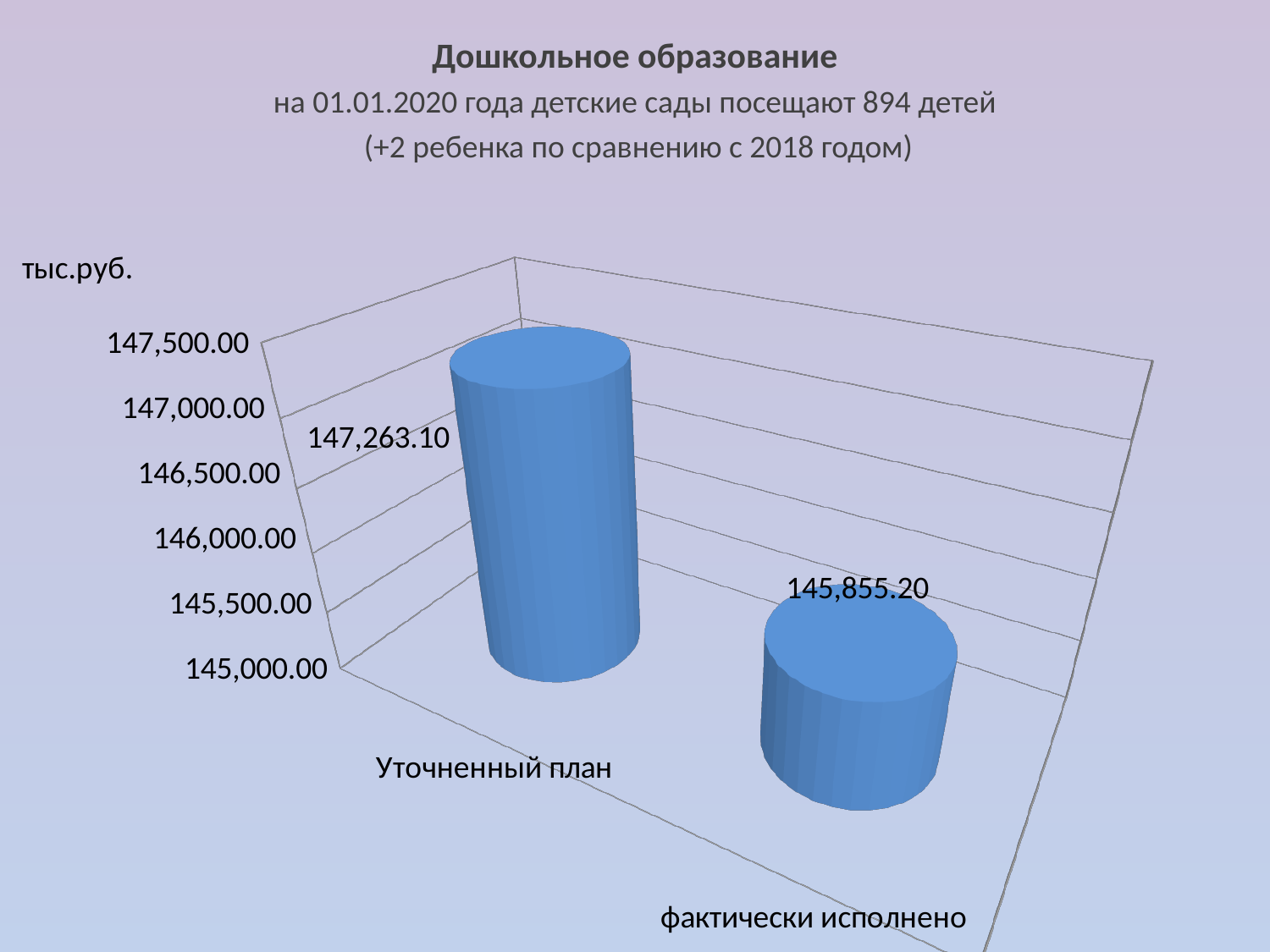
Is the value for Уточненный план greater or less than 147,000.00? greater What unit is shown for the values on the chart? тыс.руб. How many categories are shown in the chart? 2 Which category has the lowest value? фактически исполнено Which category has the highest value? Уточненный план What is the title of the chart? тыс.руб. What is the value for Уточненный план? 147,263.10 What is the value for фактически исполнено? 145,855.20 What is the difference between Уточненный план and фактически исполнено? 1,407.90 Which is larger, Уточненный план or фактически исполнено? Уточненный план What kind of chart is shown on the slide? bar chart Is the value for фактически исполнено greater or less than 146,000.00? less